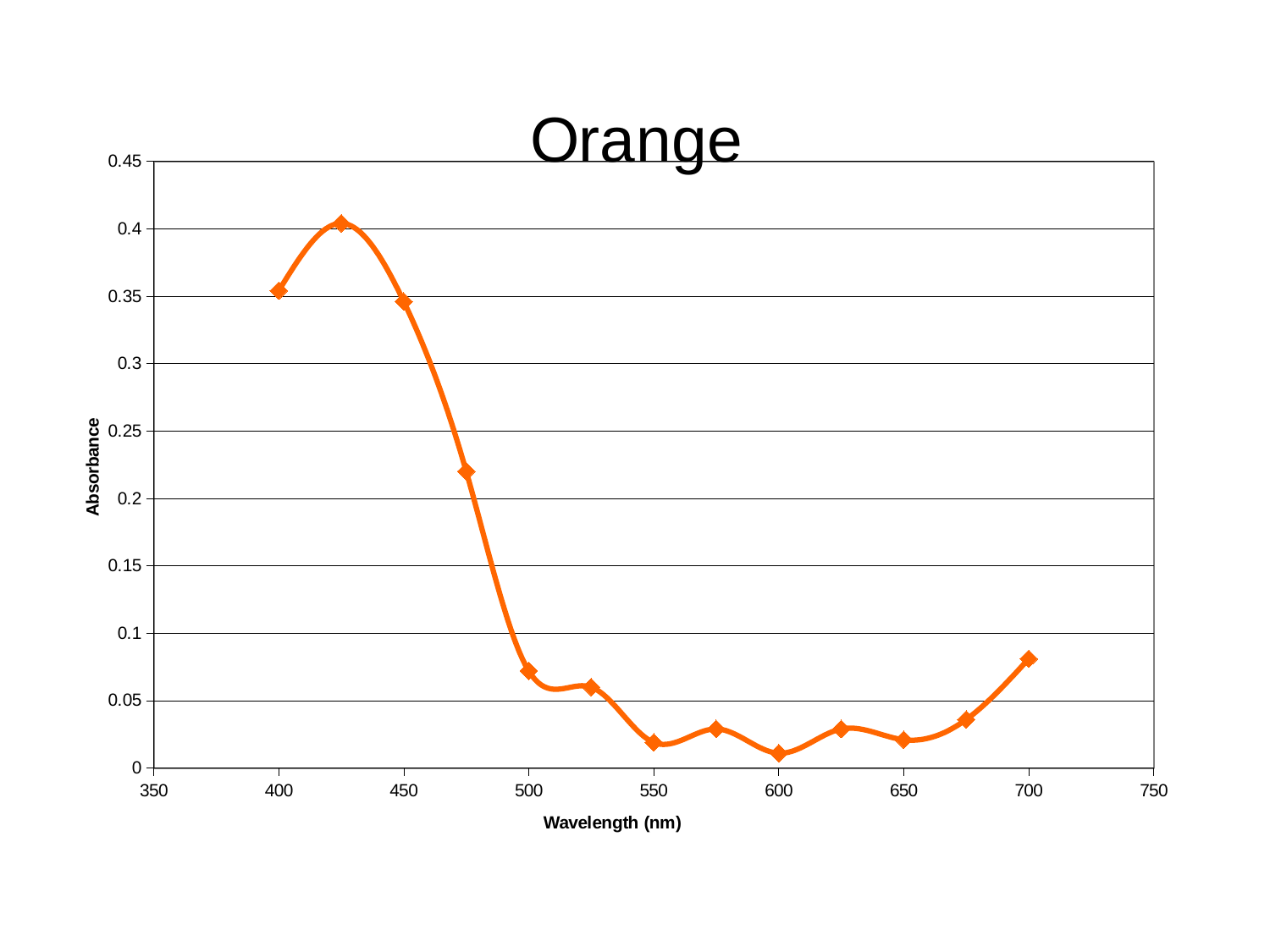
What is the title of the chart? Orange Is the absorbance at 475 nm greater or less than 0.2? greater Which has the higher absorbance, 475 nm or 500 nm? 475 nm What kind of chart is shown on the slide? Line chart What is the label of the x axis? Wavelength (nm) Is the absorbance at 425 nm greater or less than 0.35? greater Which has the higher absorbance, 675 nm or 700 nm? 700 nm How many data points are plotted on the line? 13 Does the absorbance rise or fall between 425 nm and 550 nm? Fall Is the absorbance at 500 nm greater or less than 0.1? less At which wavelength is the absorbance highest? 425